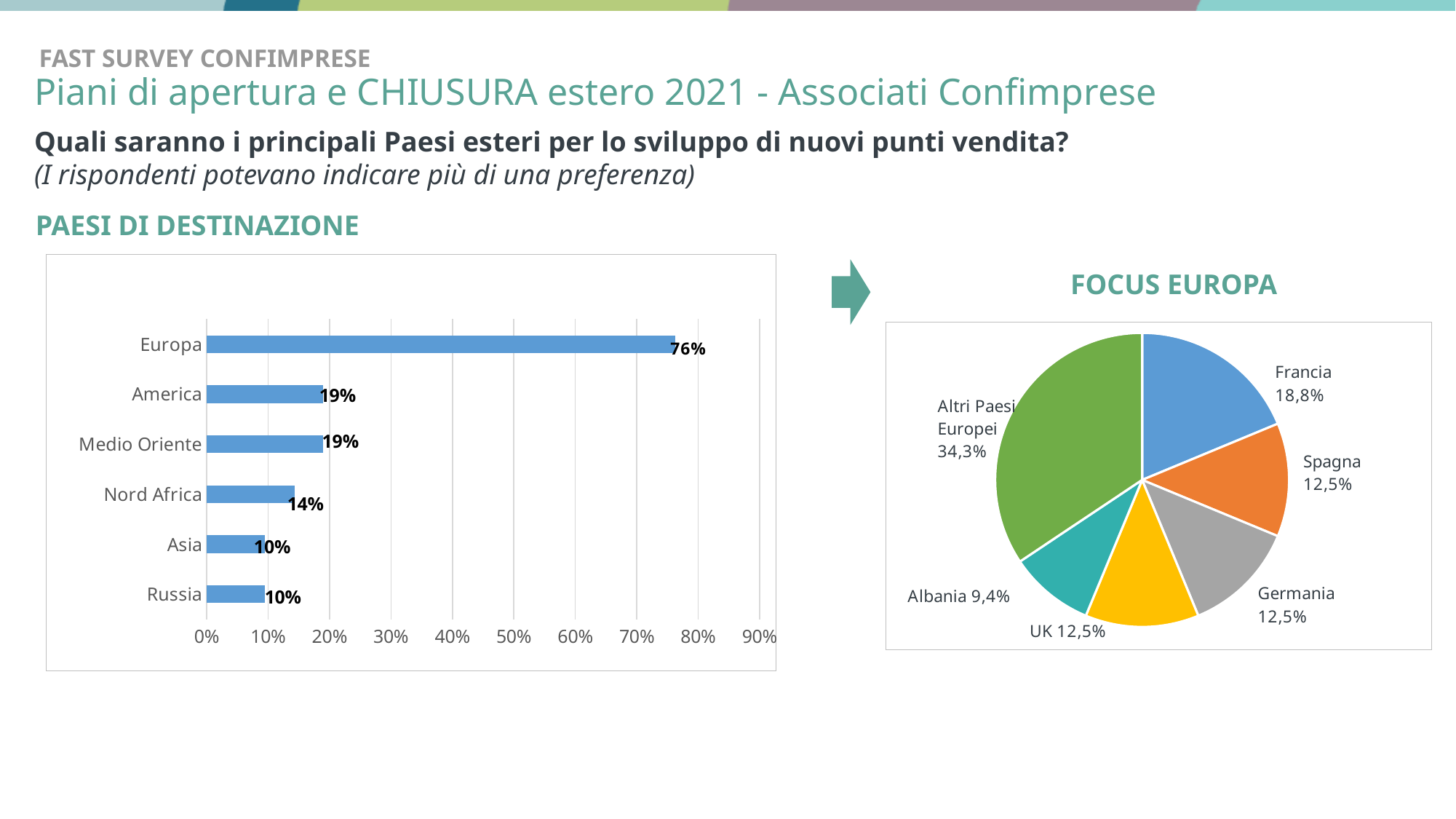
In the FOCUS EUROPA pie chart, what is the share for Francia? 18,8% What kind of chart is the FOCUS EUROPA chart? Pie chart In the PAESI DI DESTINAZIONE bar chart, which is larger, the value for Medio Oriente or the value for Nord Africa? Medio Oriente What kind of chart is the PAESI DI DESTINAZIONE chart? Bar chart In the PAESI DI DESTINAZIONE bar chart, what is the value for Europa? 76% In the PAESI DI DESTINAZIONE bar chart, what is the difference between the values for Europa and America? 57% In the PAESI DI DESTINAZIONE bar chart, what is the value for Nord Africa? 14% In the PAESI DI DESTINAZIONE bar chart, which category has the highest value? Europa In the FOCUS EUROPA pie chart, which slice is the largest? Altri Paesi Europei In the FOCUS EUROPA pie chart, what is the share for Albania? 9,4% In the FOCUS EUROPA pie chart, how many slices are there? 6 In the PAESI DI DESTINAZIONE bar chart, how many categories are shown? 6